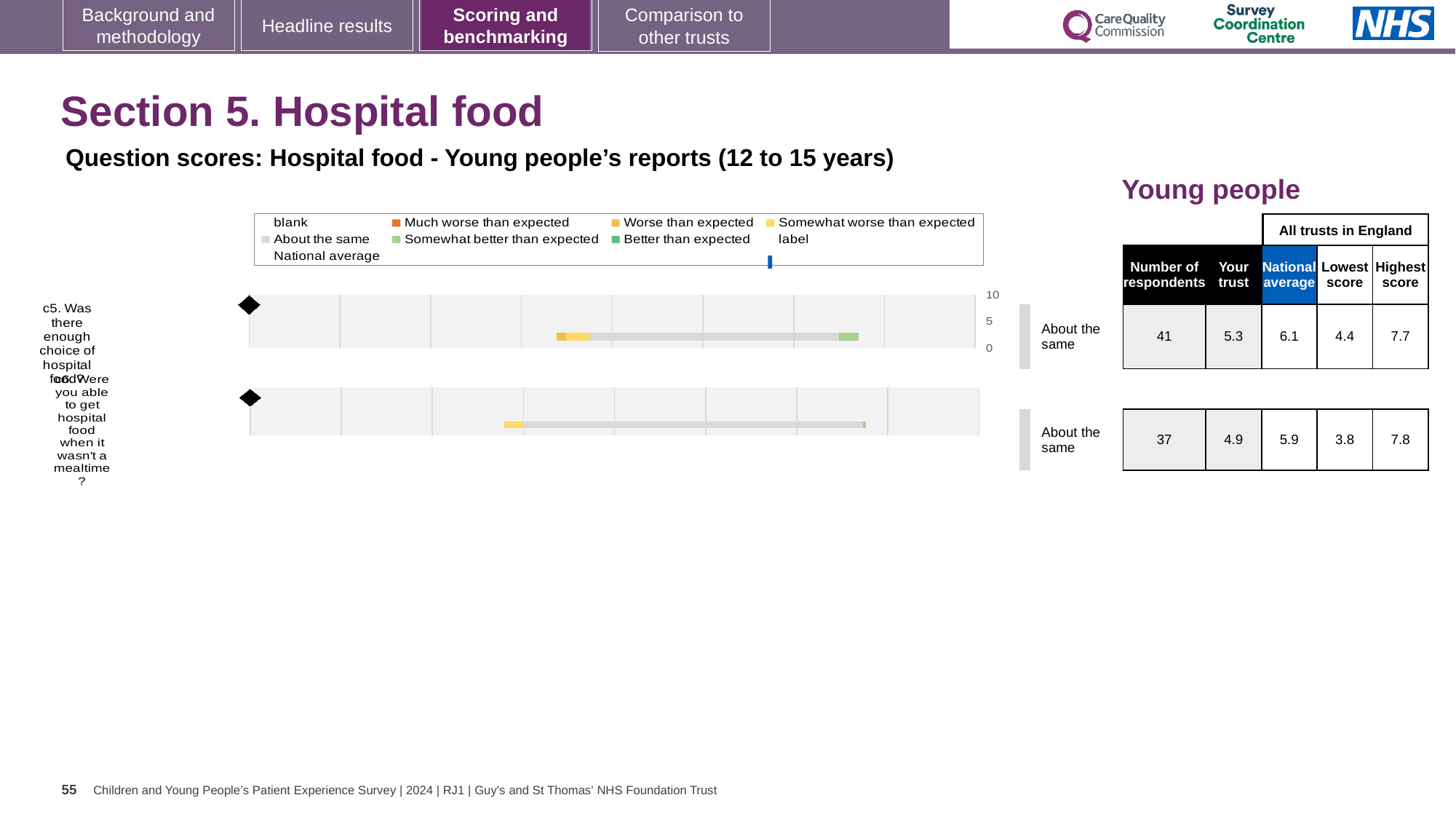
What is the 'Your trust' score for c5 'Was there enough choice of hospital food?'? 5.3 Which question has the higher 'Your trust' score, c5 or c6? c5 What colour does the legend use for 'Much worse than expected'? Orange What is the highest score among all trusts in England for c6 'Were you able to get hospital food when it wasn't a mealtime?'? 7.8 What benchmark category is given for c6 'Were you able to get hospital food when it wasn't a mealtime?'? About the same What is the difference between the national average and the 'Your trust' score for c5? 0.8 How many survey questions (bars) are plotted in the hospital food chart? 2 How many respondents answered c6 'Were you able to get hospital food when it wasn't a mealtime?'? 37 What kind of chart is used to show the question scores for hospital food? Bar chart Which legend entry in the hospital food chart is shown in blue? National average Which question has the lower lowest score across all trusts in England, c5 or c6? c6 What is the national average score for c5 'Was there enough choice of hospital food?'? 6.1